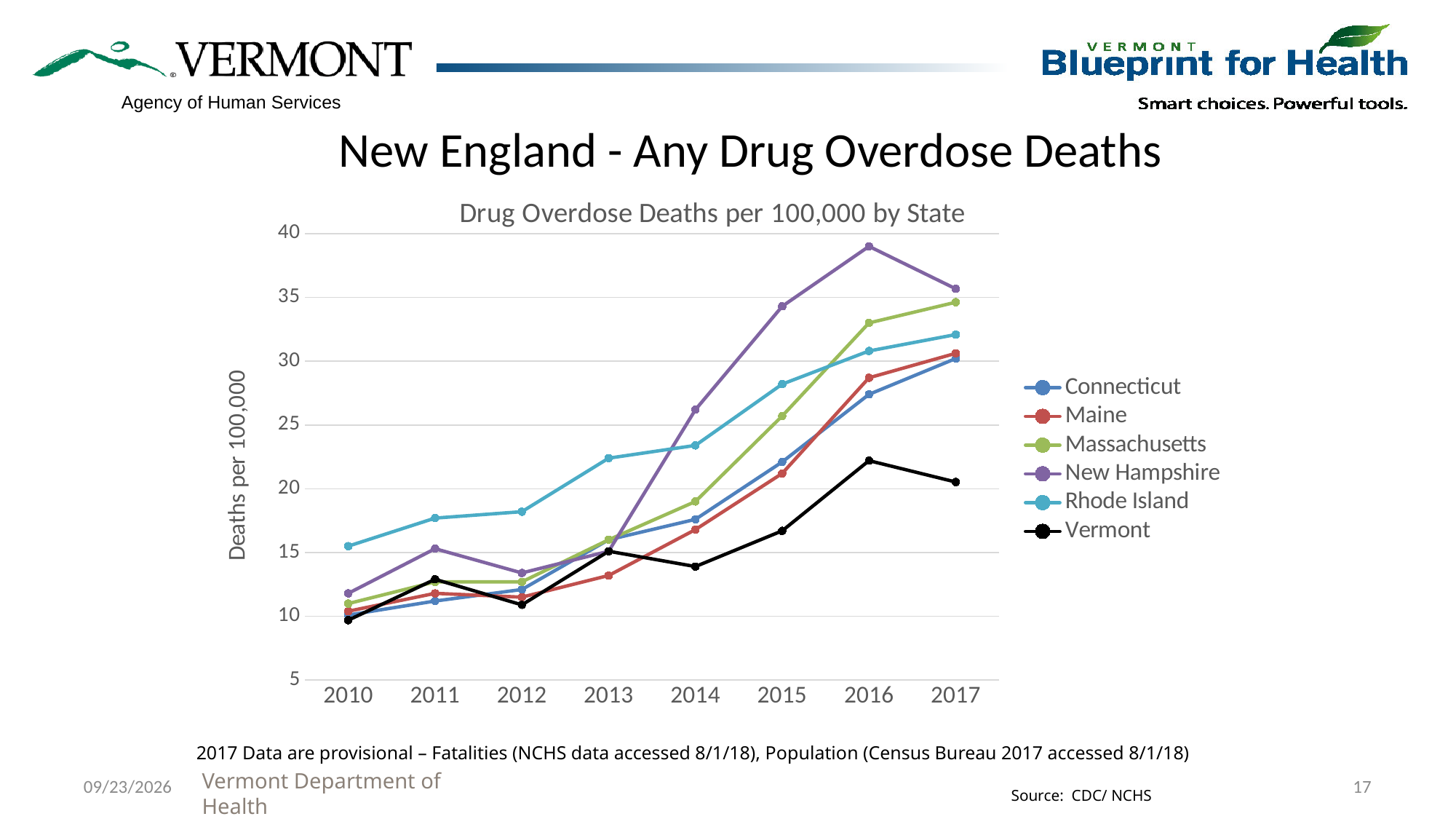
Is the value for Maine in 2013 greater or less than 15? less How many states (series) does the legend list? 6 Which state has the highest drug overdose death rate in 2016? New Hampshire What is the title of the y axis? Deaths per 100,000 Is the value for Vermont in 2016 greater or less than 20? greater Which state has the lowest drug overdose death rate in 2017? Vermont Is the value for Massachusetts in 2017 greater or less than 30? greater What kind of chart is shown on the slide? line chart Does the Vermont line rise or fall from 2016 to 2017? fall How many years are plotted along the x axis? 8 In 2014, which is larger: the value for New Hampshire or the value for Massachusetts? New Hampshire Which state has the highest drug overdose death rate in 2010? Rhode Island